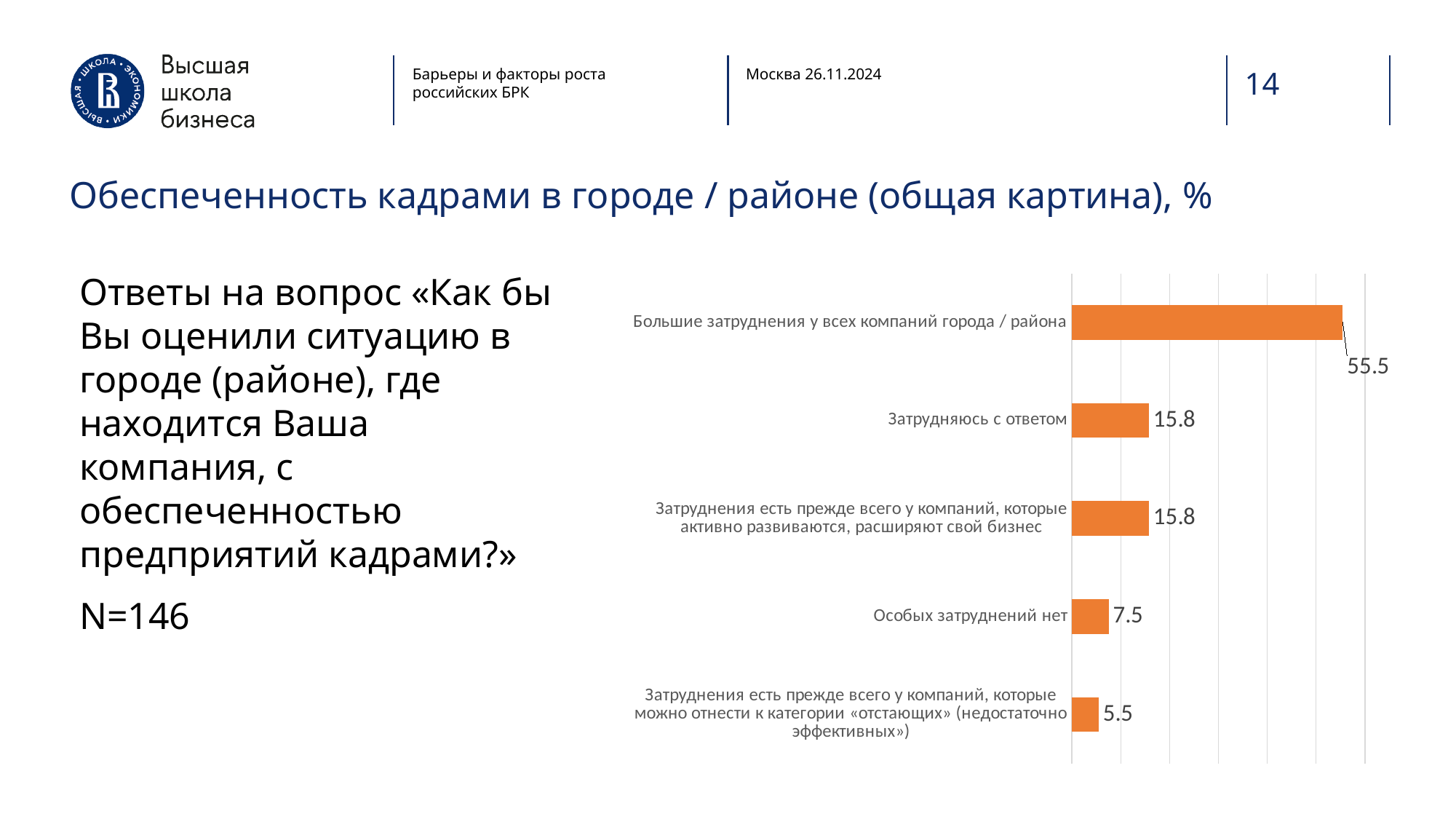
What is the value for the category about companies that are actively developing and expanding their business? 15.8 What is the difference between the values for «Большие затруднения у всех компаний города / района» and «Затрудняюсь с ответом»? 39.7 What is the value for the category about companies in the «отстающих» (недостаточно эффективных) group? 5.5 Which category has the highest value? Большие затруднения у всех компаний города / района How many categories are shown in the chart? 5 What is the value for «Большие затруднения у всех компаний города / района»? 55.5 What is the value for «Затрудняюсь с ответом»? 15.8 What is the value for «Особых затруднений нет»? 7.5 Which category has the lowest value? Затруднения есть прежде всего у компаний, которые можно отнести к категории «отстающих» (недостаточно эффективных) Which is larger: the value for «Особых затруднений нет» or the value for «Затрудняюсь с ответом»? Затрудняюсь с ответом What type of chart is shown on the slide? Bar chart What is the difference between the values for «Особых затруднений нет» and the «отстающих» category? 2.0